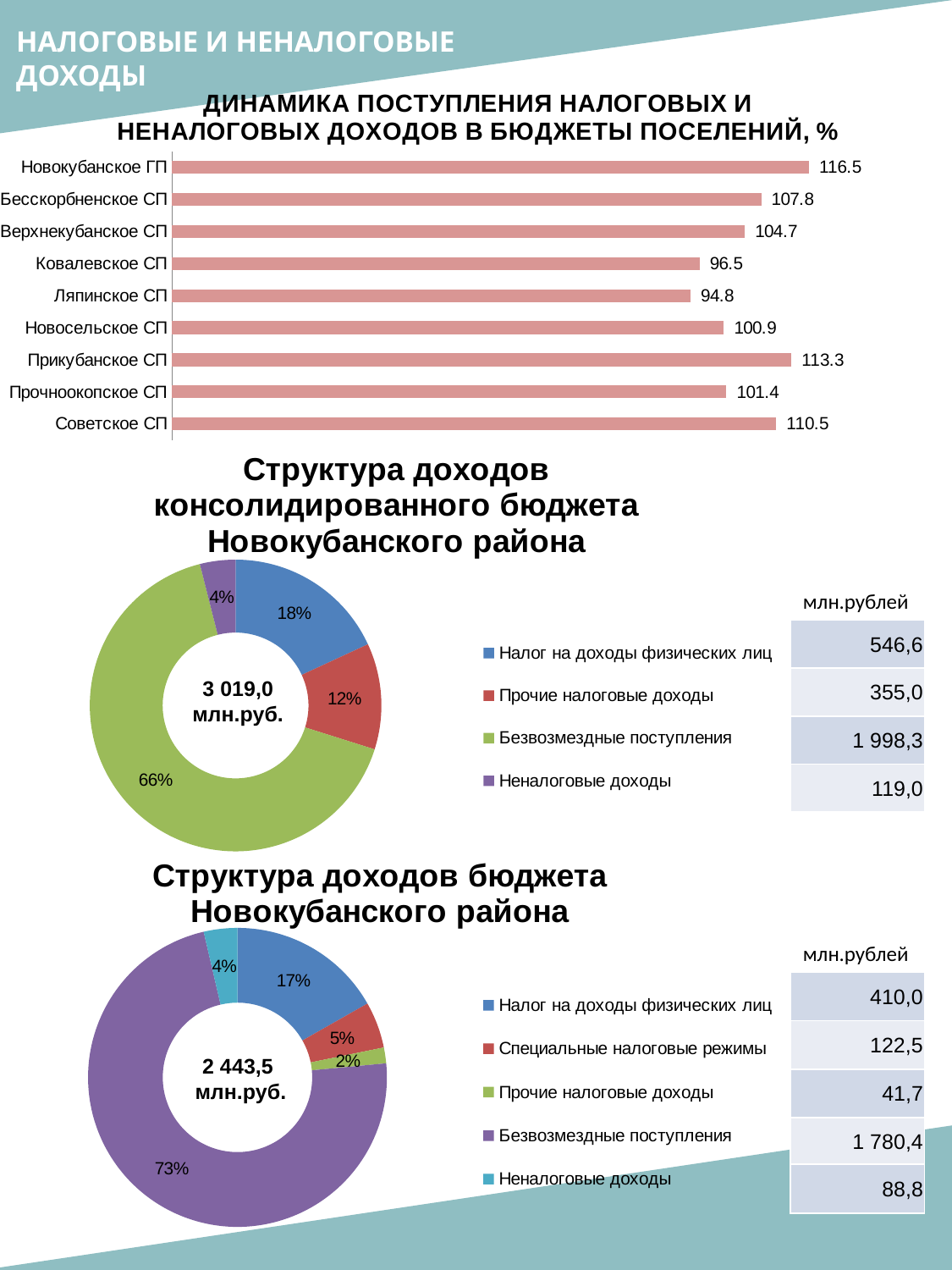
On the chart 'ДИНАМИКА ПОСТУПЛЕНИЯ НАЛОГОВЫХ И НЕНАЛОГОВЫХ ДОХОДОВ В БЮДЖЕТЫ ПОСЕЛЕНИЙ, %', which settlement has the lowest value? Ляпинское СП On the chart 'ДИНАМИКА ПОСТУПЛЕНИЯ НАЛОГОВЫХ И НЕНАЛОГОВЫХ ДОХОДОВ В БЮДЖЕТЫ ПОСЕЛЕНИЙ, %', what is the value for Ковалевское СП? 96.5 How many categories does the legend list on the chart 'Структура доходов бюджета Новокубанского района'? 5 On the chart 'ДИНАМИКА ПОСТУПЛЕНИЯ НАЛОГОВЫХ И НЕНАЛОГОВЫХ ДОХОДОВ В БЮДЖЕТЫ ПОСЕЛЕНИЙ, %', what is the difference between Прикубанское СП and Советское СП? 2.8 On the chart 'ДИНАМИКА ПОСТУПЛЕНИЯ НАЛОГОВЫХ И НЕНАЛОГОВЫХ ДОХОДОВ В БЮДЖЕТЫ ПОСЕЛЕНИЙ, %', which is larger: Бесскорбненское СП or Верхнекубанское СП? Бесскорбненское СП What type of chart is 'ДИНАМИКА ПОСТУПЛЕНИЯ НАЛОГОВЫХ И НЕНАЛОГОВЫХ ДОХОДОВ В БЮДЖЕТЫ ПОСЕЛЕНИЙ, %'? Bar chart On the chart 'Структура доходов консолидированного бюджета Новокубанского района', what is the total shown in the centre of the doughnut? 3 019,0 млн.руб. On the chart 'ДИНАМИКА ПОСТУПЛЕНИЯ НАЛОГОВЫХ И НЕНАЛОГОВЫХ ДОХОДОВ В БЮДЖЕТЫ ПОСЕЛЕНИЙ, %', which settlement has the highest value? Новокубанское ГП How many settlements are shown on the chart 'ДИНАМИКА ПОСТУПЛЕНИЯ НАЛОГОВЫХ И НЕНАЛОГОВЫХ ДОХОДОВ В БЮДЖЕТЫ ПОСЕЛЕНИЙ, %'? 9 On the chart 'Структура доходов бюджета Новокубанского района', what share is Налог на доходы физических лиц? 17% On the chart 'Структура доходов бюджета Новокубанского района', which category has the largest share? Безвозмездные поступления On the chart 'Структура доходов консолидированного бюджета Новокубанского района', what share is Безвозмездные поступления? 66%